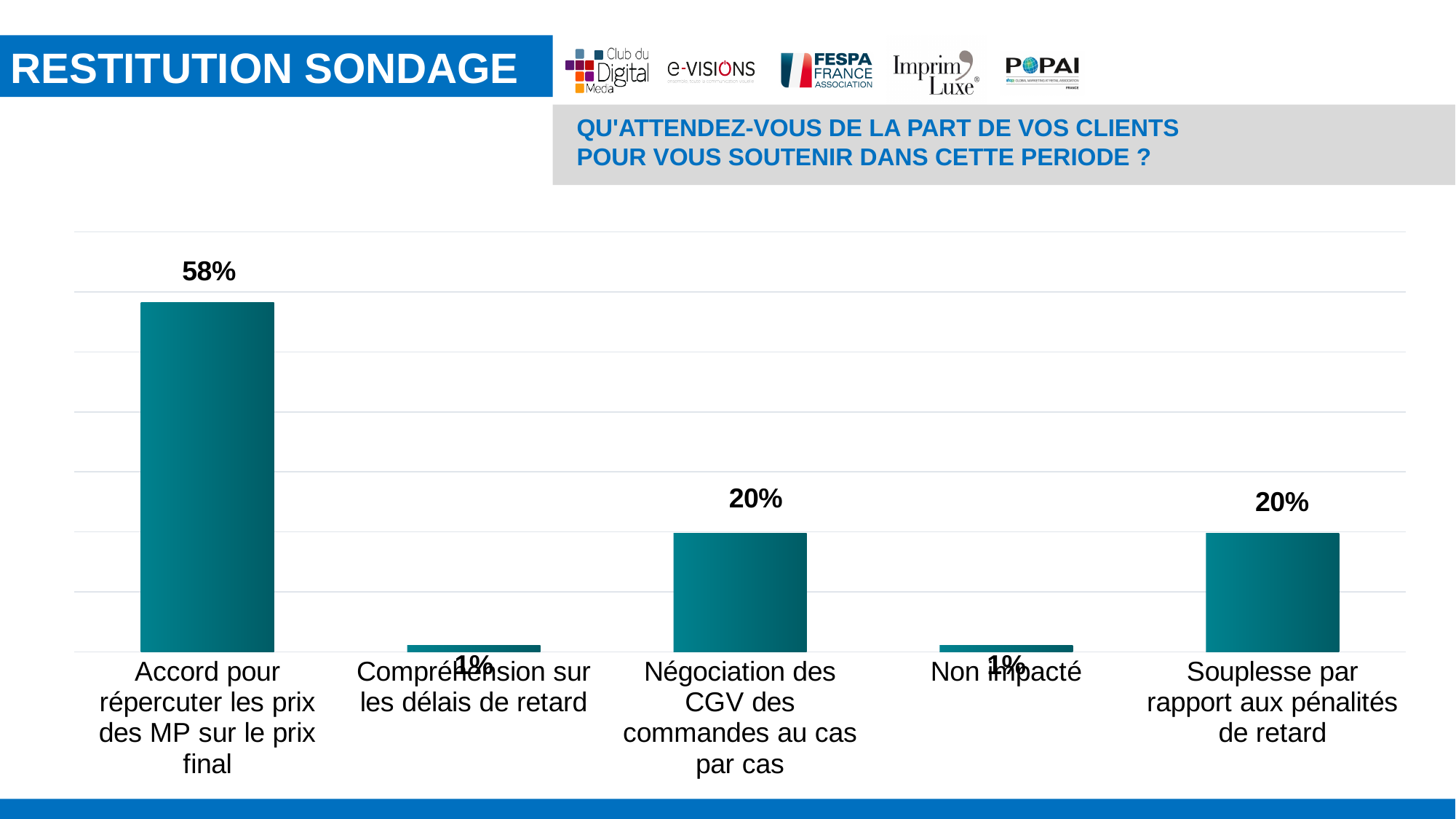
What is the difference between the values for "Souplesse par rapport aux pénalités de retard" and "Non impacté"? 19% Which category has the highest value? Accord pour répercuter les prix des MP sur le prix final What question does the chart answer, according to the text above it? Qu'attendez-vous de la part de vos clients pour vous soutenir dans cette periode ? What is the value for "Souplesse par rapport aux pénalités de retard"? 20% What kind of chart is shown on the slide? Bar chart What is the value for "Non impacté"? 1% What is the value for "Négociation des CGV des commandes au cas par cas"? 20% What is the value for "Compréhension sur les délais de retard"? 1% Which is larger, the value for "Négociation des CGV des commandes au cas par cas" or the value for "Compréhension sur les délais de retard"? Négociation des CGV des commandes au cas par cas What is the difference between the values for "Accord pour répercuter les prix des MP sur le prix final" and "Négociation des CGV des commandes au cas par cas"? 38% How many categories are shown in the chart? 5 What is the value for "Accord pour répercuter les prix des MP sur le prix final"? 58%